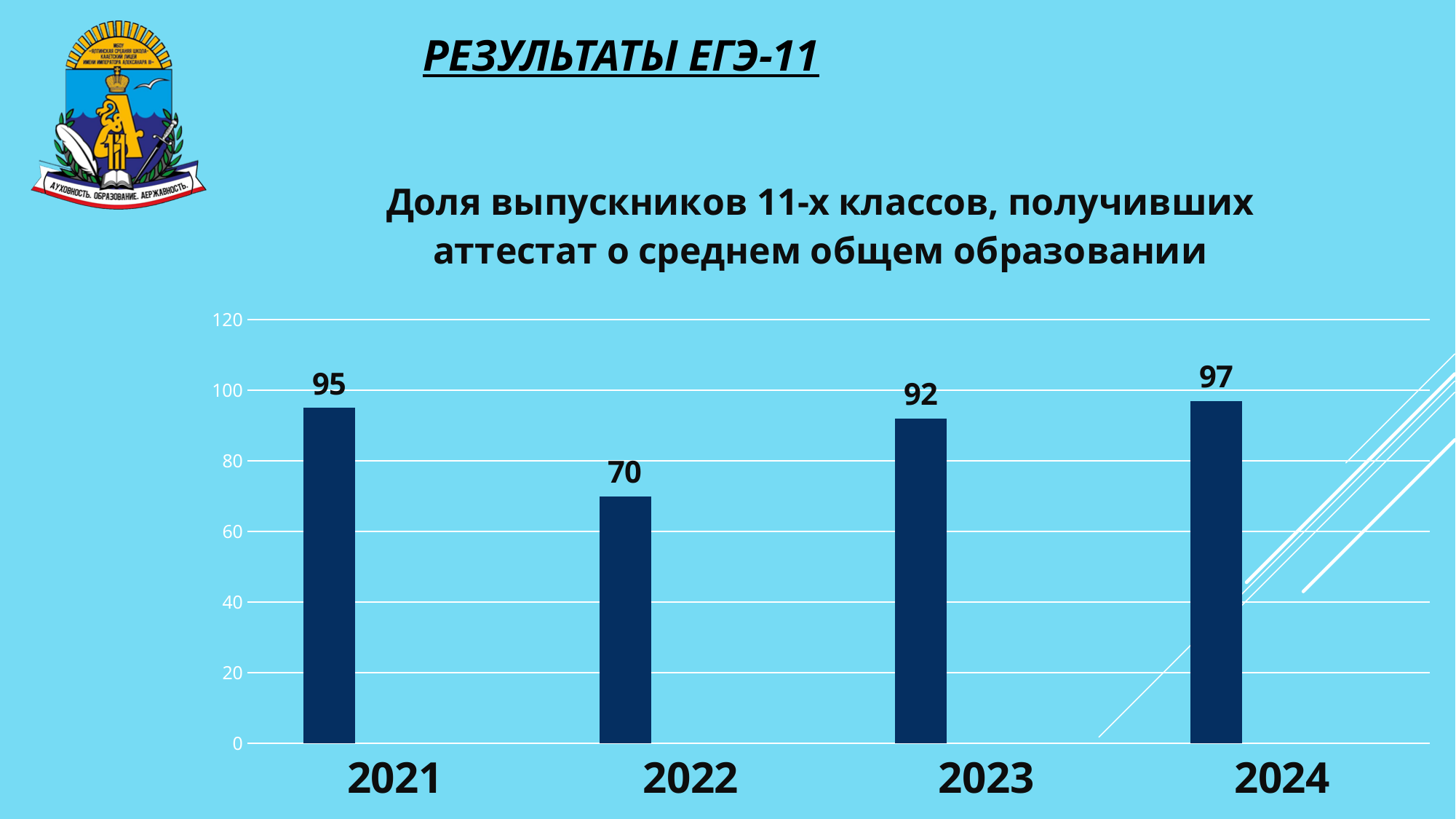
What kind of chart is shown on the slide? bar chart What is the difference between the values for 2021 and 2022? 25 Which is larger, the value for 2021 or the value for 2023? 2021 How many years are shown on the x axis? 4 What is the value for 2024? 97 What is the difference between the values for 2024 and 2023? 5 What is the value for 2021? 95 Which year has the highest value? 2024 What is the value for 2023? 92 What is the title of the chart? Доля выпускников 11-х классов, получивших аттестат о среднем общем образовании What is the value for 2022? 70 Which year has the lowest value? 2022